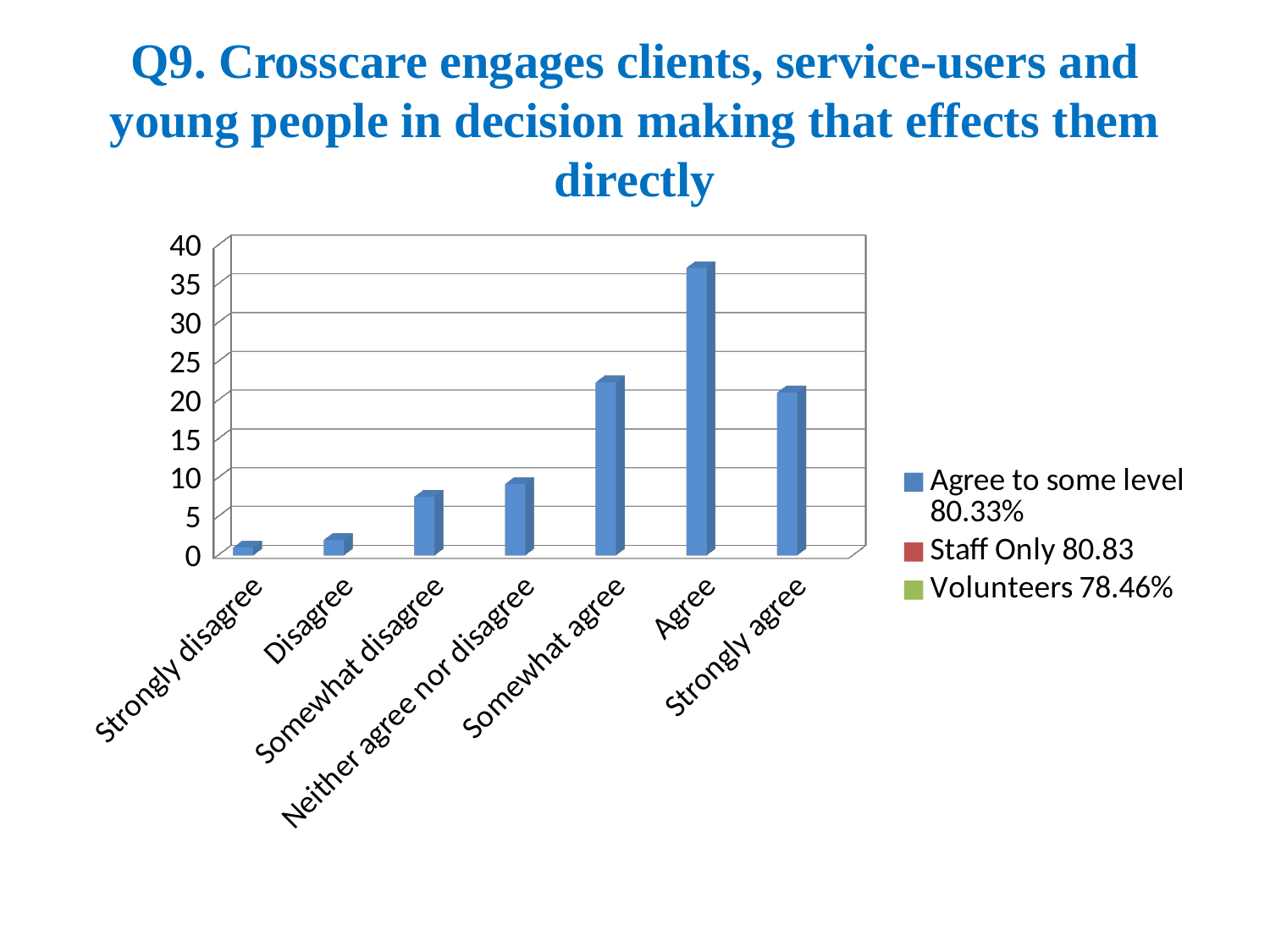
What percentage is given in the legend for 'Agree to some level'? 80.33% What percentage is given in the legend for Volunteers? 78.46% Is the value for Disagree greater or less than 5? less Is the value for Somewhat disagree greater or less than 10? less What kind of chart is shown on the slide? bar chart How many entries does the chart's legend list? 3 Which is larger, the value for Agree or the value for Somewhat agree? Agree Is the value for Agree greater or less than 35? greater Which is larger, the value for Agree or the value for Strongly agree? Agree How many categories are shown on the x axis of the chart? 7 Which category has the lowest bar in the chart? Strongly disagree Which category has the highest bar in the chart? Agree